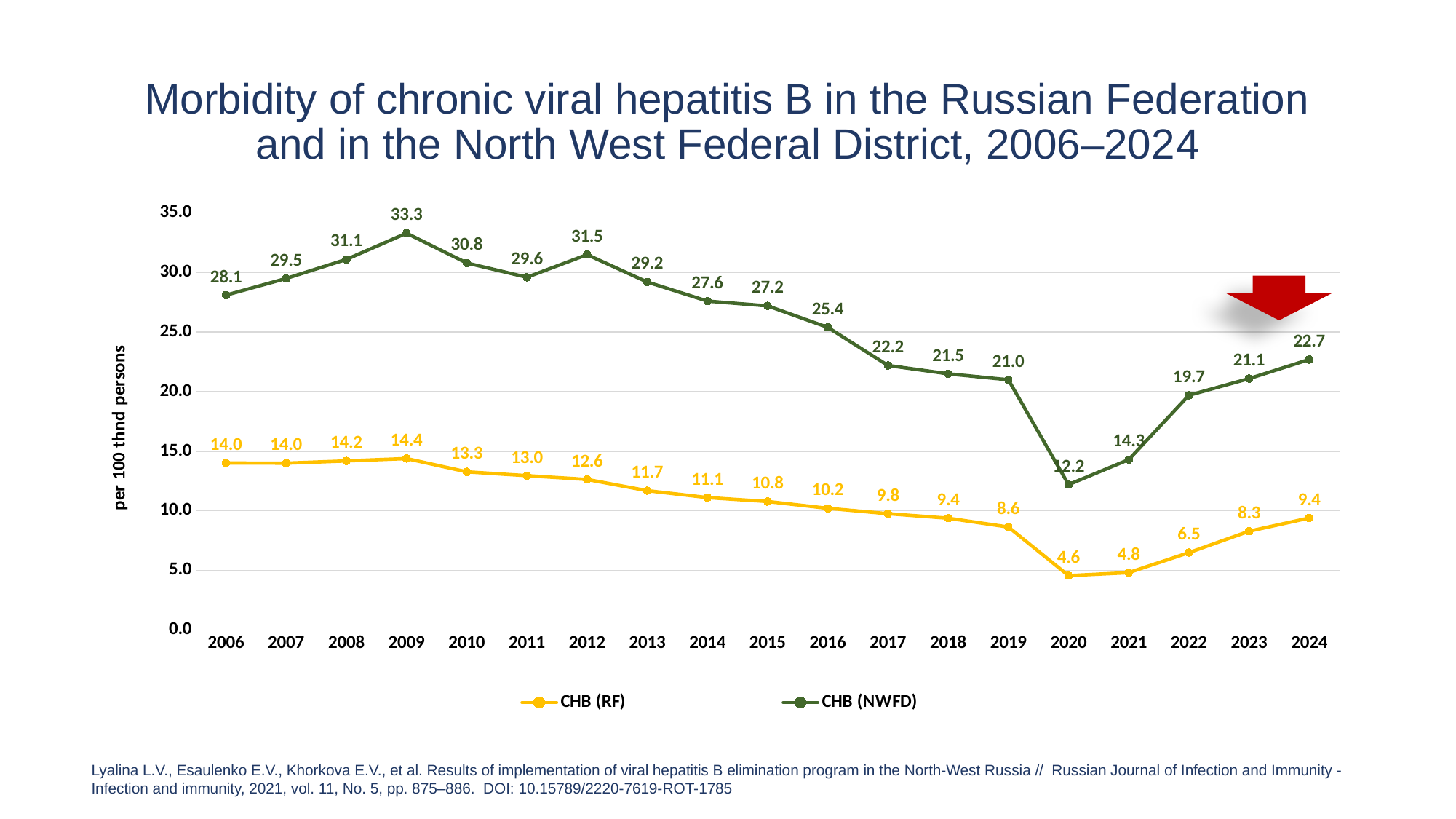
In which year is the CHB (RF) series at its lowest? 2020 What is the difference between the CHB (NWFD) and CHB (RF) values in 2024? 13.3 What is the y-axis label of the chart? per 100 thnd persons Does the CHB (RF) series rise or fall from 2009 to 2020? fall What is the CHB (NWFD) value for 2020? 12.2 How many years are shown on the x axis? 19 What kind of chart is shown on the slide? line chart What is the CHB (NWFD) value for 2009? 33.3 Which is larger, the CHB (NWFD) value in 2012 or in 2010? 2012 What is the CHB (RF) value for 2020? 4.6 In which year is the CHB (NWFD) series at its highest? 2009 How many series does the legend list? 2